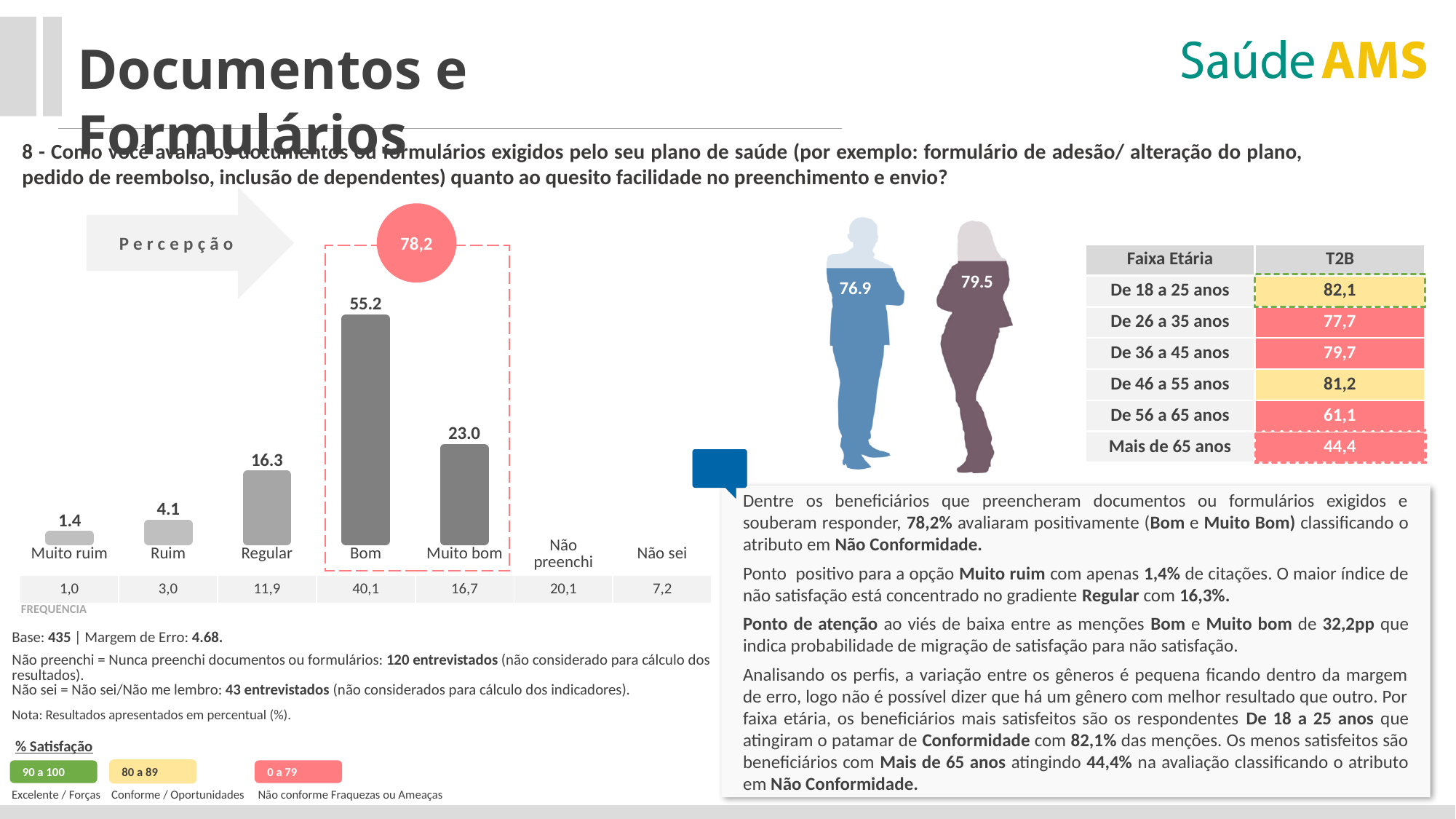
What is the value shown for the Muito ruim bar in the bar chart? 1.4 What is the value shown for the Bom bar in the bar chart? 55.2 What is the difference between the Bom and Muito bom values in the bar chart? 32.2 In the Faixa Etária table, which age group has the lowest T2B value? Mais de 65 anos Which is larger in the bar chart, the value for Ruim or the value for Regular? Regular In the Faixa Etária table, what is the T2B value for De 56 a 65 anos? 61,1 Which category has the lowest bar in the bar chart? Muito ruim What is the value shown for the Regular bar in the bar chart? 16.3 What is the total of the Bom and Muito bom values in the bar chart? 78.2 What value is shown in the red circle above the Bom and Muito bom bars? 78,2 What kind of chart is used to show the Muito ruim to Muito bom ratings? Bar chart Which category has the highest bar in the bar chart? Bom